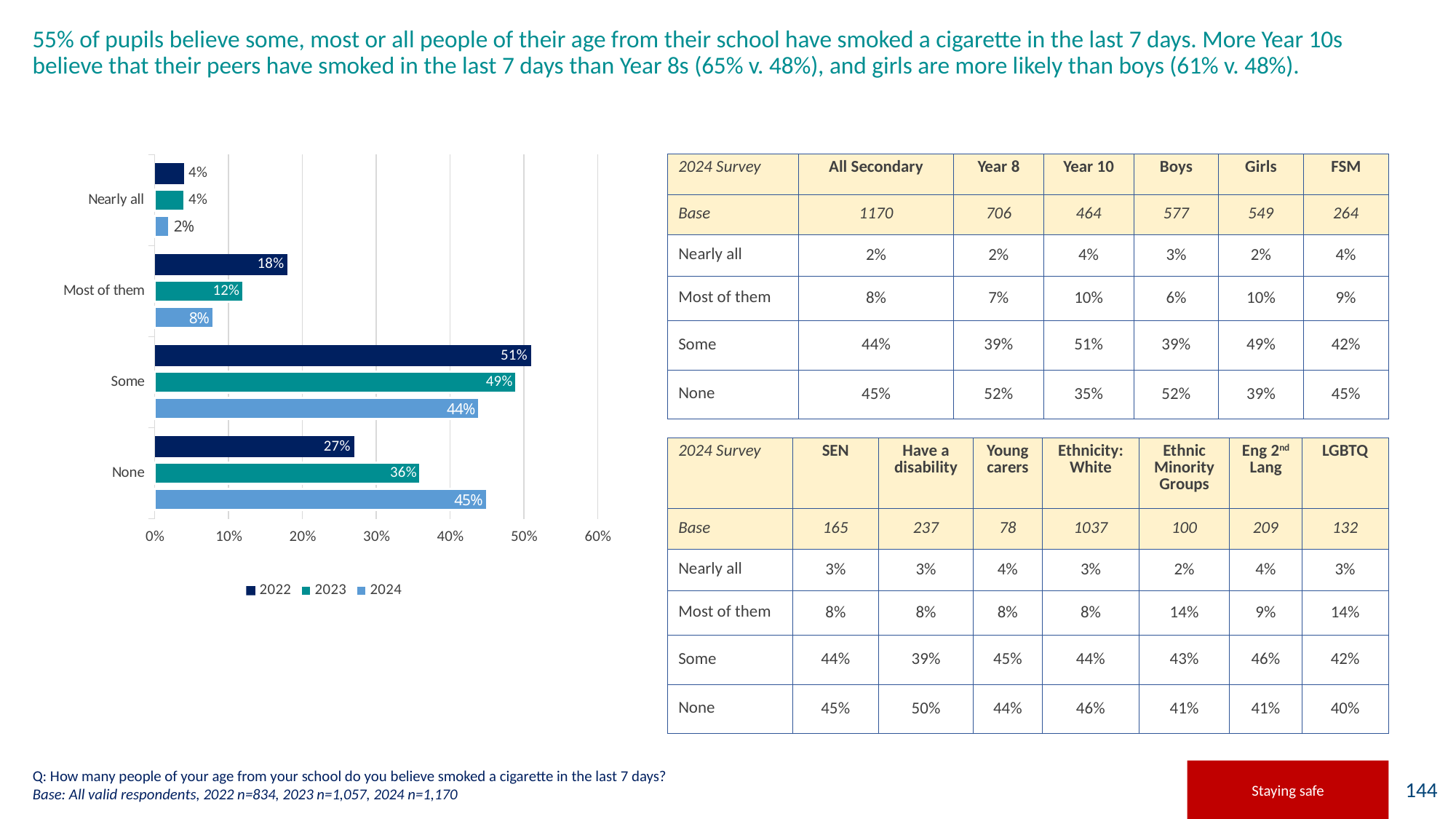
How many series does the chart's legend list? 3 Which category has the lowest 2024 value? Nearly all Which series is shown in the lightest blue colour in the legend? 2024 What is the 2023 value for 'Most of them'? 12% What is the 2022 value for 'None'? 27% What is the 2024 value for 'Some'? 44% Which is larger for 'Most of them': the 2022 value or the 2024 value? 2022 What kind of chart is shown on the slide? Bar chart Which category has the highest 2022 value? Some Does the value for 'None' rise or fall from 2022 to 2024? Rise How many categories are shown on the chart's vertical axis? 4 What is the difference between the 2024 and 2022 values for 'None'? 18%